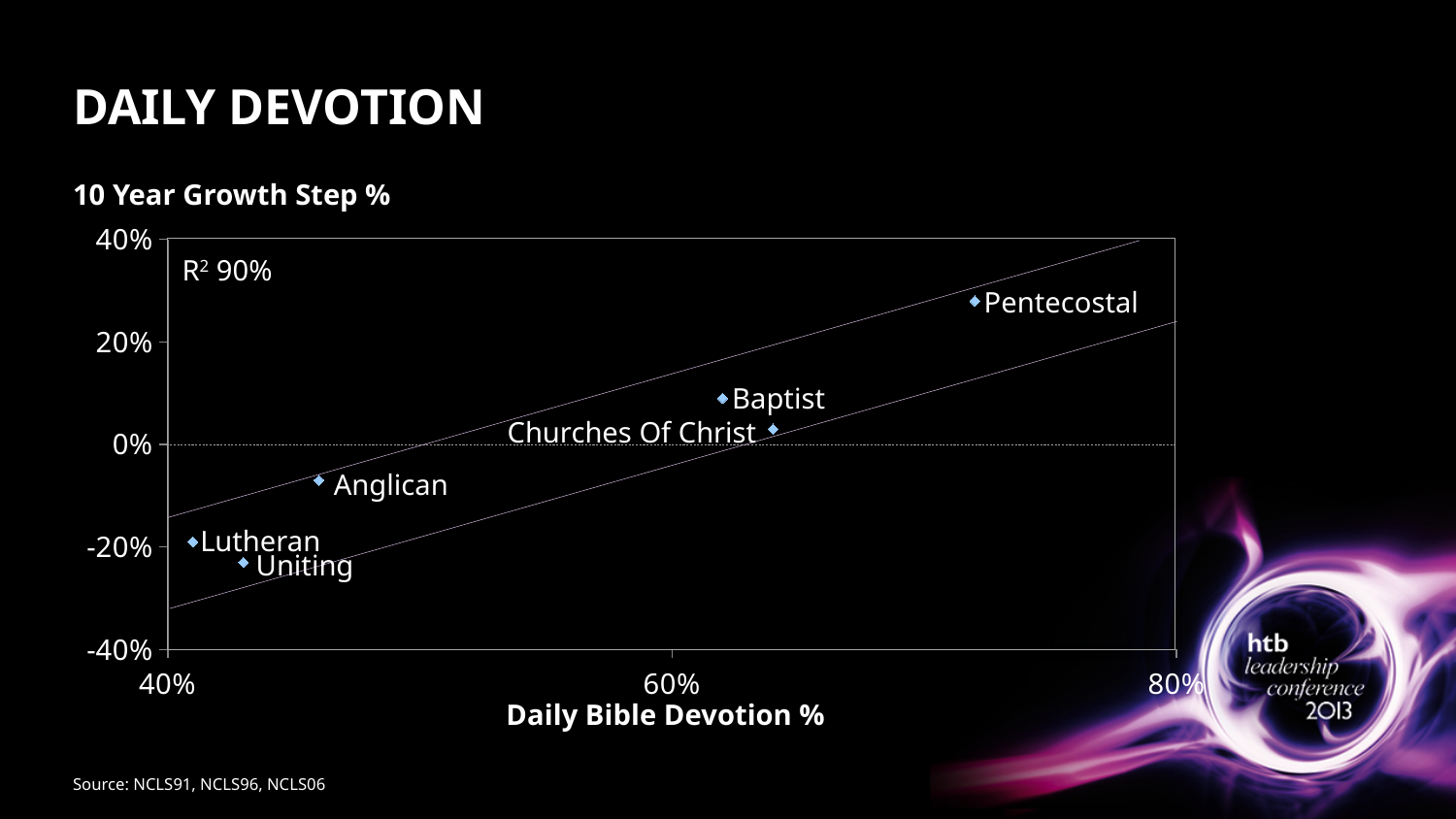
Which denomination has the highest 10 Year Growth Step %? Pentecostal Is the 10 Year Growth Step % for Anglican greater or less than 0%? less As Daily Bible Devotion % increases along the x axis, does the 10 Year Growth Step % generally rise or fall? rise Which denomination has the lowest 10 Year Growth Step %? Uniting Is the 10 Year Growth Step % for Pentecostal greater or less than 20%? greater Which has a higher 10 Year Growth Step %, Baptist or Anglican? Baptist Is the Daily Bible Devotion % for Lutheran greater or less than 60%? less How many denominations are plotted as points on the chart? 6 What kind of chart is shown on the slide? scatter chart What R² value is shown on the chart? 90%